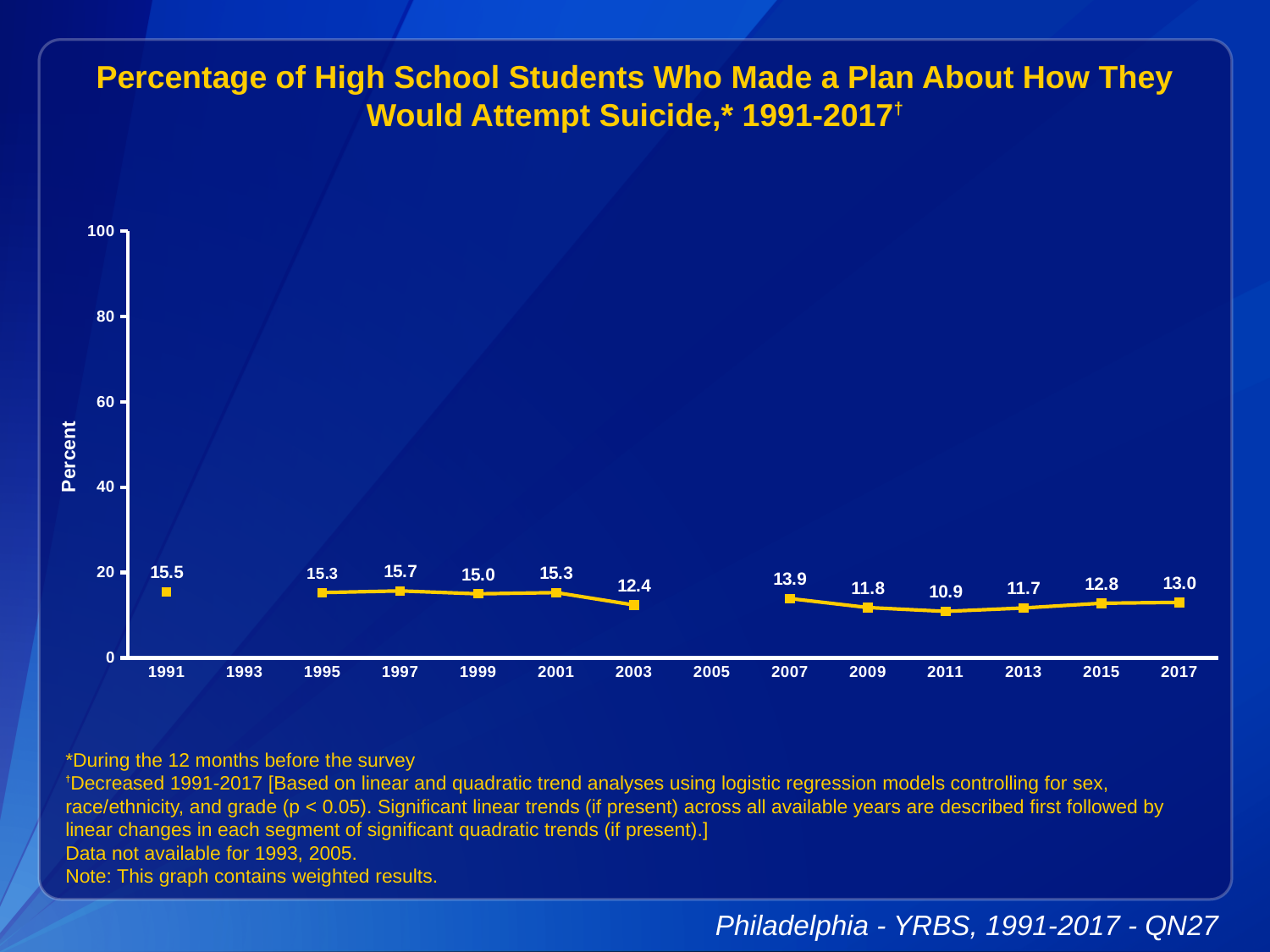
What is the value for 1991? 15.5 Do the values generally rise or fall from 1991 to 2017? fall Which year has the lowest value? 2011 What is the difference between the values for 1991 and 2017? 2.5 What kind of chart is shown? line chart How many data points are plotted on the chart? 12 What is the value for 2011? 10.9 Which is larger, the value for 2003 or the value for 2007? 2007 Which year has the highest value? 1997 Is the value for 1997 greater or less than 20? less What is the label on the y axis? Percent What is the value for 2017? 13.0